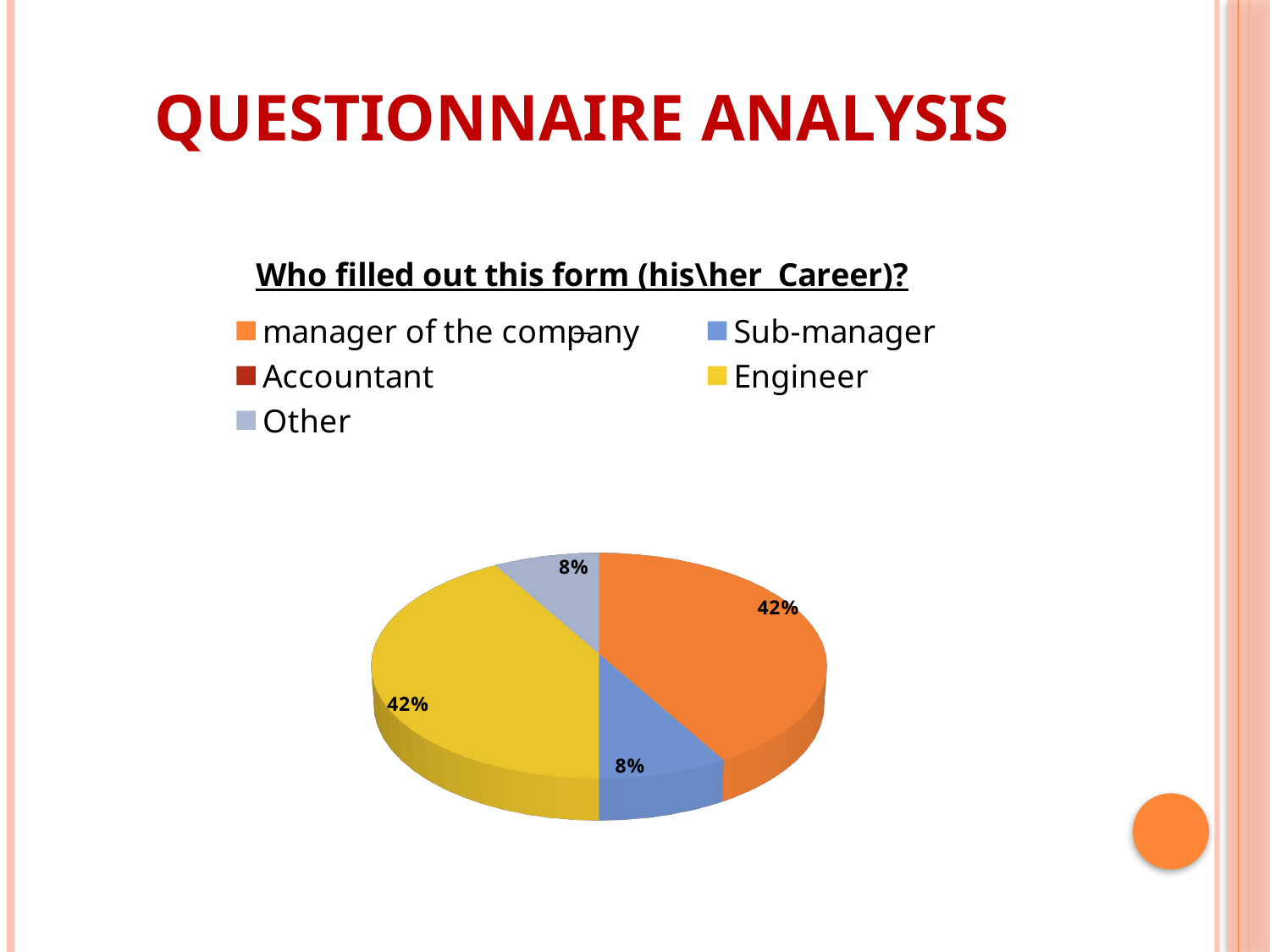
What percentage of respondents were the manager of the company? 42% What is the difference in percentage points between the manager of the company share and the Sub-manager share? 34 What percentage of respondents were Engineers? 42% What colour represents Engineer in the chart? yellow What percentage of respondents were Sub-managers? 8% Which is larger: the share for Engineer or the share for Other? Engineer Which is larger: the share for manager of the company or the share for Sub-manager? manager of the company How many categories does the legend list? 5 What is the title of the chart? Who filled out this form (his\her Career)? What type of chart is shown on the slide? pie chart What is the combined share of manager of the company and Engineer? 84% What percentage of respondents fall under Other? 8%